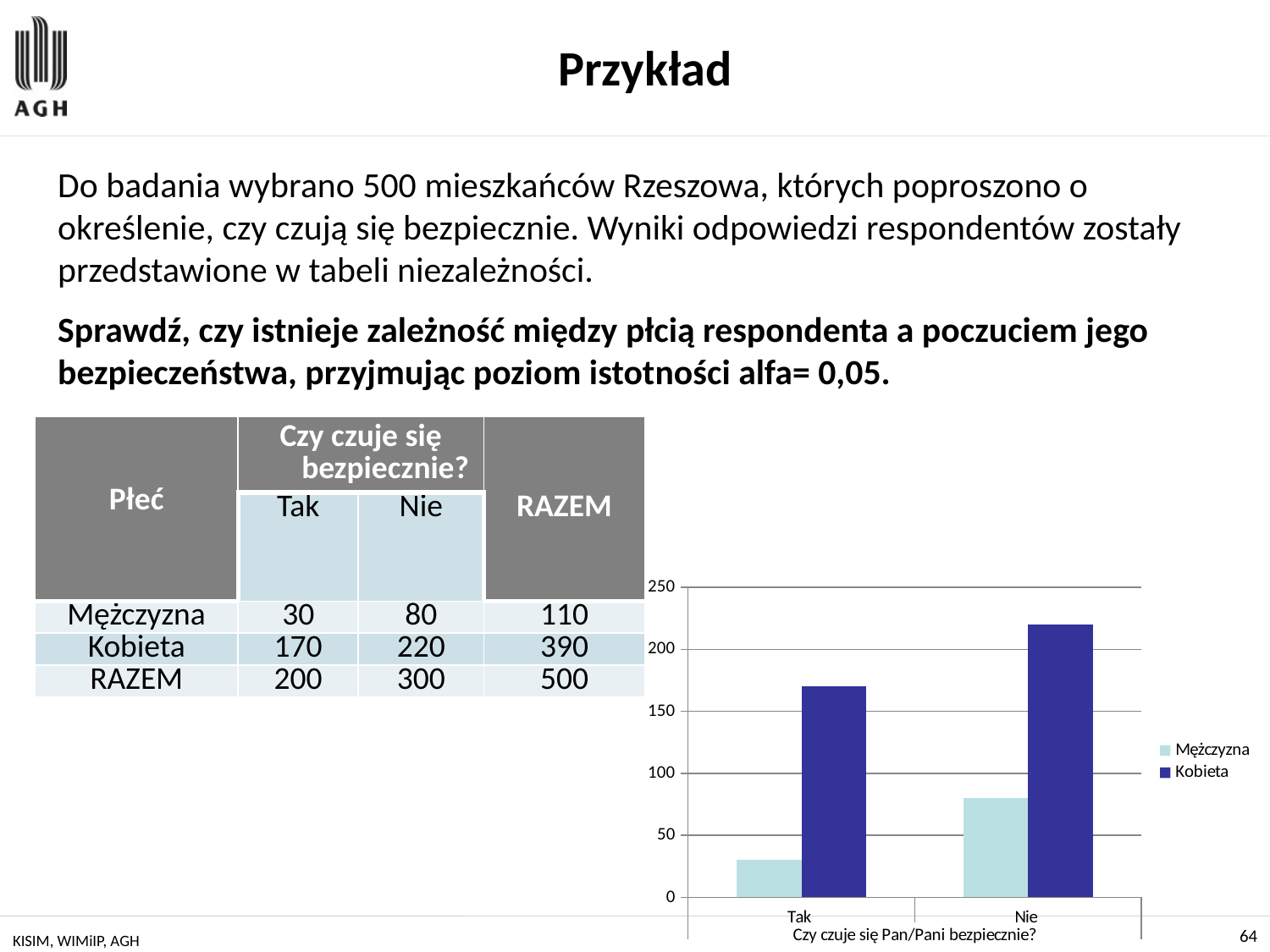
Is the value for Mężczyzna in the category Nie greater or less than 100? less Which series has the taller bar for the category Nie? Kobieta How many categories are shown on the x axis of the chart? 2 What kind of chart is shown on the slide? bar chart What is the difference between the Kobieta and Mężczyzna values in the category Tak? 140 What is the value for Mężczyzna in the category Tak? 30 What is the value for Kobieta in the category Nie? 220 Is the value for Mężczyzna in the category Tak greater or less than 50? less What is the x-axis title of the chart? Czy czuje się Pan/Pani bezpiecznie? Is the value for Kobieta in the category Nie greater or less than 200? greater How many series does the chart legend list? 2